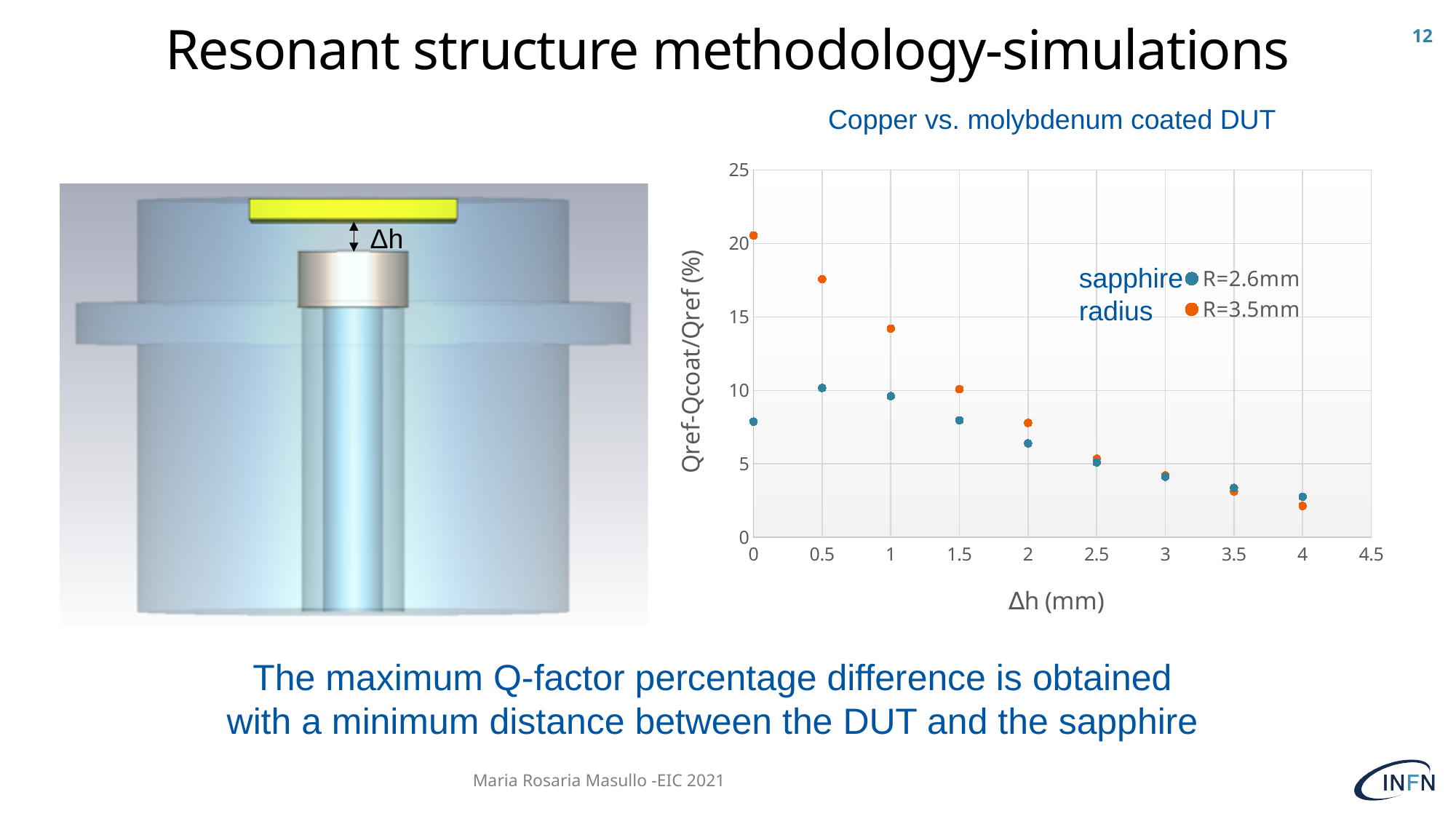
Is the value for R=3.5mm at Δh = 1 greater or less than 15? less At which Δh value does the R=3.5mm series reach its highest value? 0 Is the value for R=3.5mm at Δh = 0 greater or less than 20? greater How many data points are plotted for the R=3.5mm series? 9 What kind of chart is shown on the slide? scatter chart What is the title of the chart? Copper vs. molybdenum coated DUT Do the values of the R=3.5mm series rise or fall as Δh increases? fall How many series does the chart legend list? 2 What is the label of the x axis of the chart? Δh (mm) Is the value for R=2.6mm at Δh = 0 greater or less than 10? less At Δh = 0.5, which series has the larger value, R=2.6mm or R=3.5mm? R=3.5mm